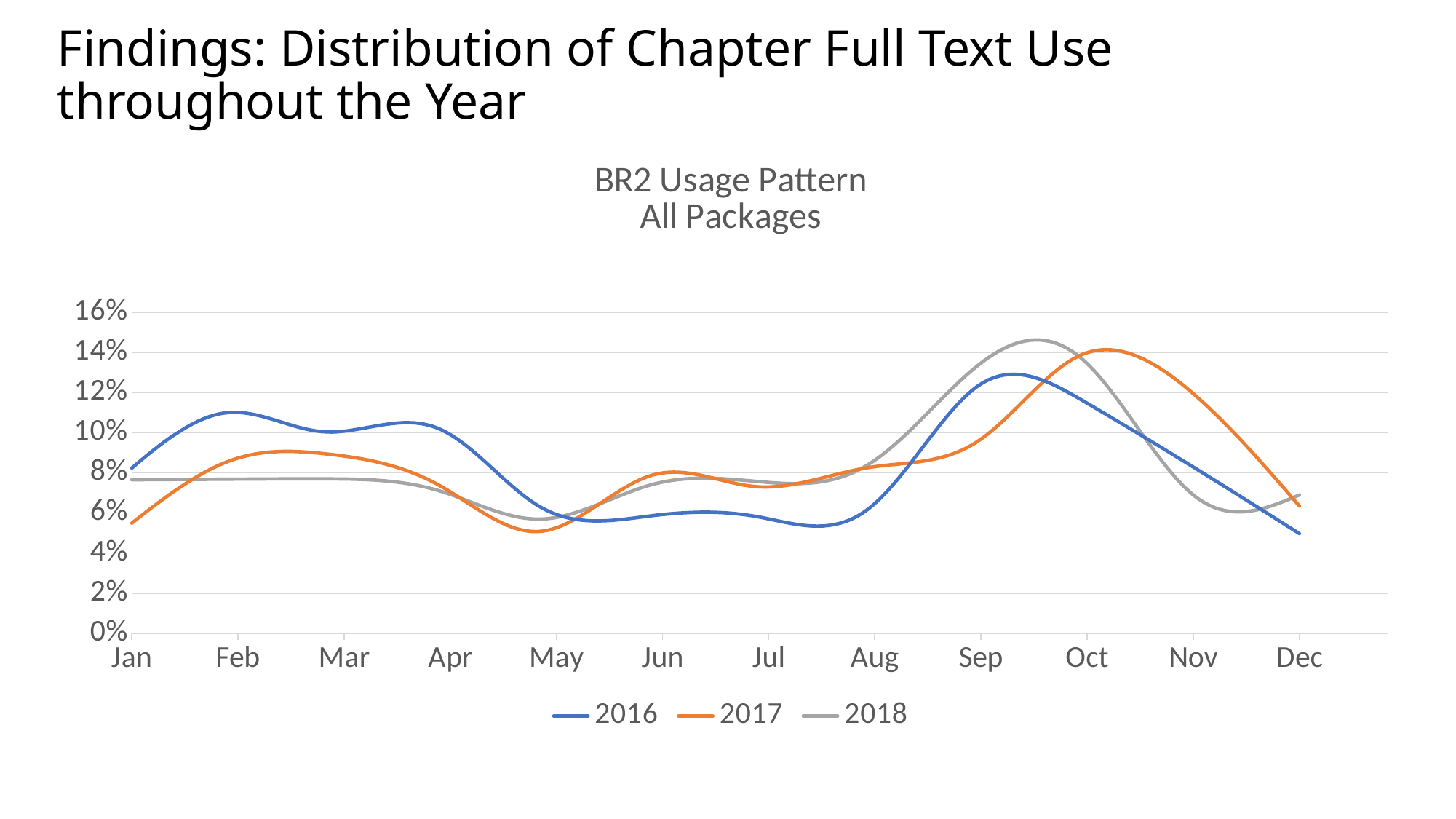
Does the 2016 series rise or fall from Sep to Dec? fall Is the value for 2017 in Jan greater or less than 6%? less Is the value for 2016 in Feb greater or less than 10%? greater Is the value for 2017 in Oct greater or less than 12%? greater In Nov, which series has the higher value, 2017 or 2018? 2017 How many series does the legend list? 3 What type of chart is shown on the slide? line chart In Feb, which series has the higher value, 2016 or 2017? 2016 Which colour is used for the 2017 series? orange What is the title of the chart? BR2 Usage Pattern All Packages How many months are shown along the x axis? 12